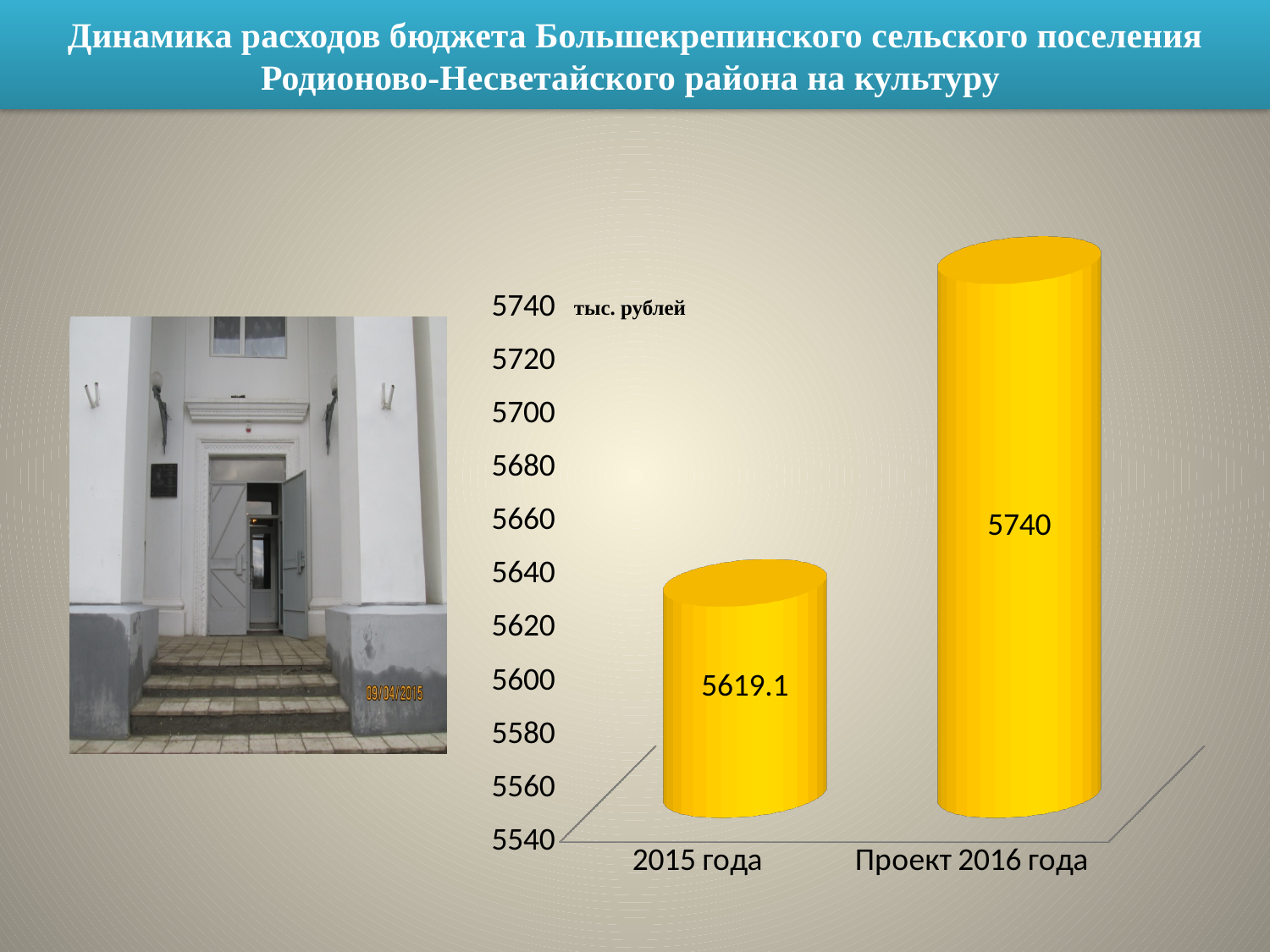
What is the value for 2015 года? 5619.1 Is the value for 2015 года greater or less than 5600? greater Which category has the lowest value? 2015 года How many categories are shown on the x axis? 2 What is the value for Проект 2016 года? 5740 Do the values rise or fall from 2015 года to Проект 2016 года? rise Which is larger, the value for 2015 года or the value for Проект 2016 года? Проект 2016 года What kind of chart is shown on the slide? bar chart Is the value for 2015 года greater or less than 5640? less What is the difference between the values for Проект 2016 года and 2015 года? 120.9 What unit is shown next to the top of the vertical axis? тыс. рублей Which category has the highest value? Проект 2016 года